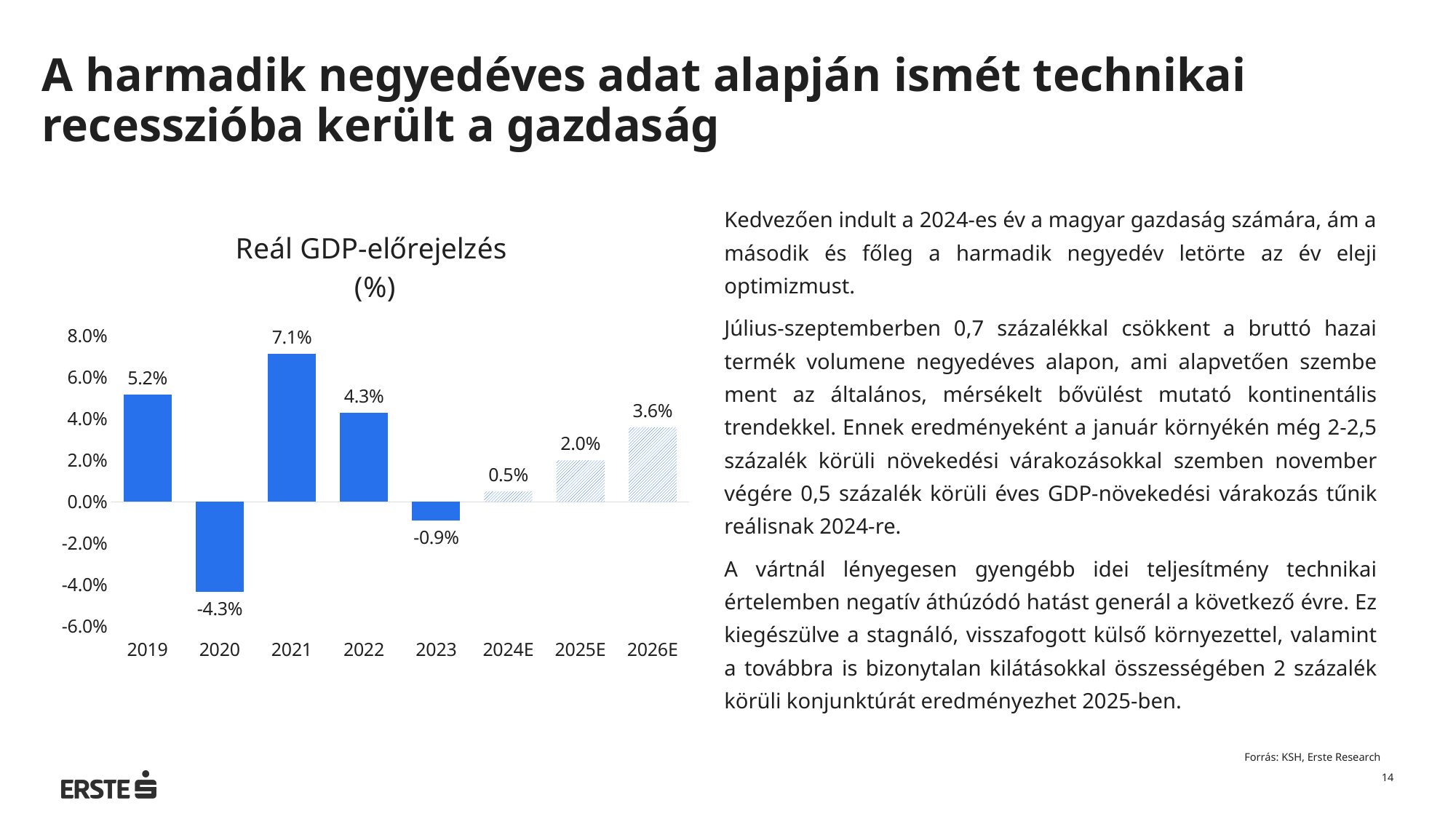
What is the title of the chart? Reál GDP-előrejelzés (%) Which year has the lowest value? 2020 Is the value for 2023 greater or less than 0.0%? less What is the value for 2024E? 0.5% What is the value for 2021? 7.1% Which is larger, the value for 2019 or the value for 2022? 2019 What is the value for 2020? -4.3% What kind of chart is shown? bar chart Which year has the highest value? 2021 How many years are shown on the x axis? 8 What is the value for 2026E? 3.6% What is the difference between the values for 2021 and 2022? 2.8%